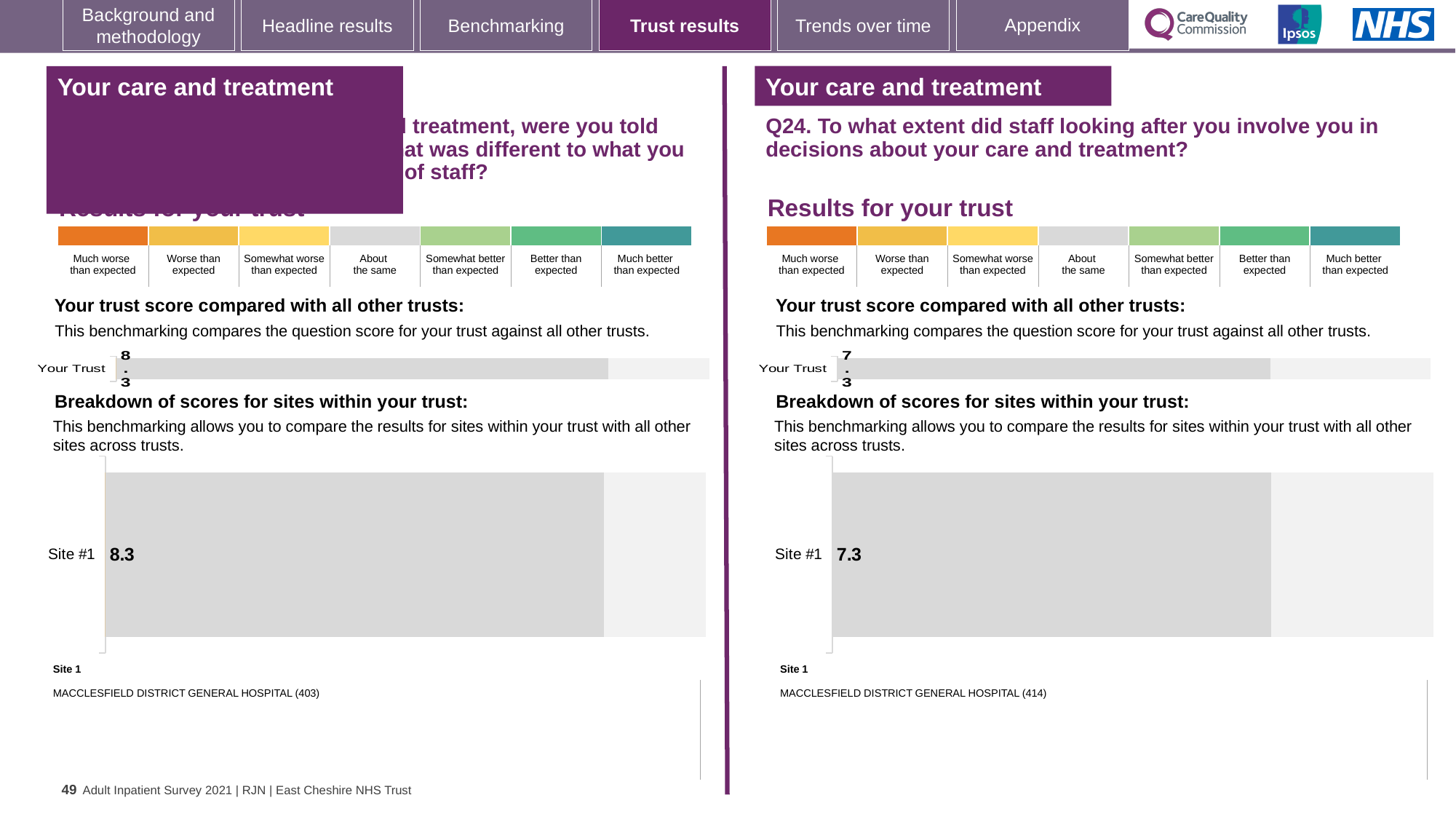
How many sites are shown in the site breakdown chart on the left panel? 1 On the right panel's (Q24) site breakdown chart, what is the score for Site #1? 7.3 Which hospital is listed as Site 1 on the right panel (Q24)? MACCLESFIELD DISTRICT GENERAL HOSPITAL (414) On the left panel, what is the score shown for Your Trust? 8.3 Which hospital is listed as Site 1 on the left panel? MACCLESFIELD DISTRICT GENERAL HOSPITAL (403) On the left panel's site breakdown chart, what is the score for Site #1? 8.3 On the right panel (Q24), what is the score shown for Your Trust? 7.3 What is the difference between the Site #1 score on the left panel and the Site #1 score on the right panel (Q24)? 1.0 How many sites are shown in the site breakdown chart on the right panel (Q24)? 1 Is the Your Trust score on the right panel (Q24) greater or less than the Site #1 score on the left panel? less What type of chart is used to show the Site #1 score on the left panel? Bar chart Which is larger: the Your Trust score on the left panel or the Your Trust score on the right panel (Q24)? Left panel